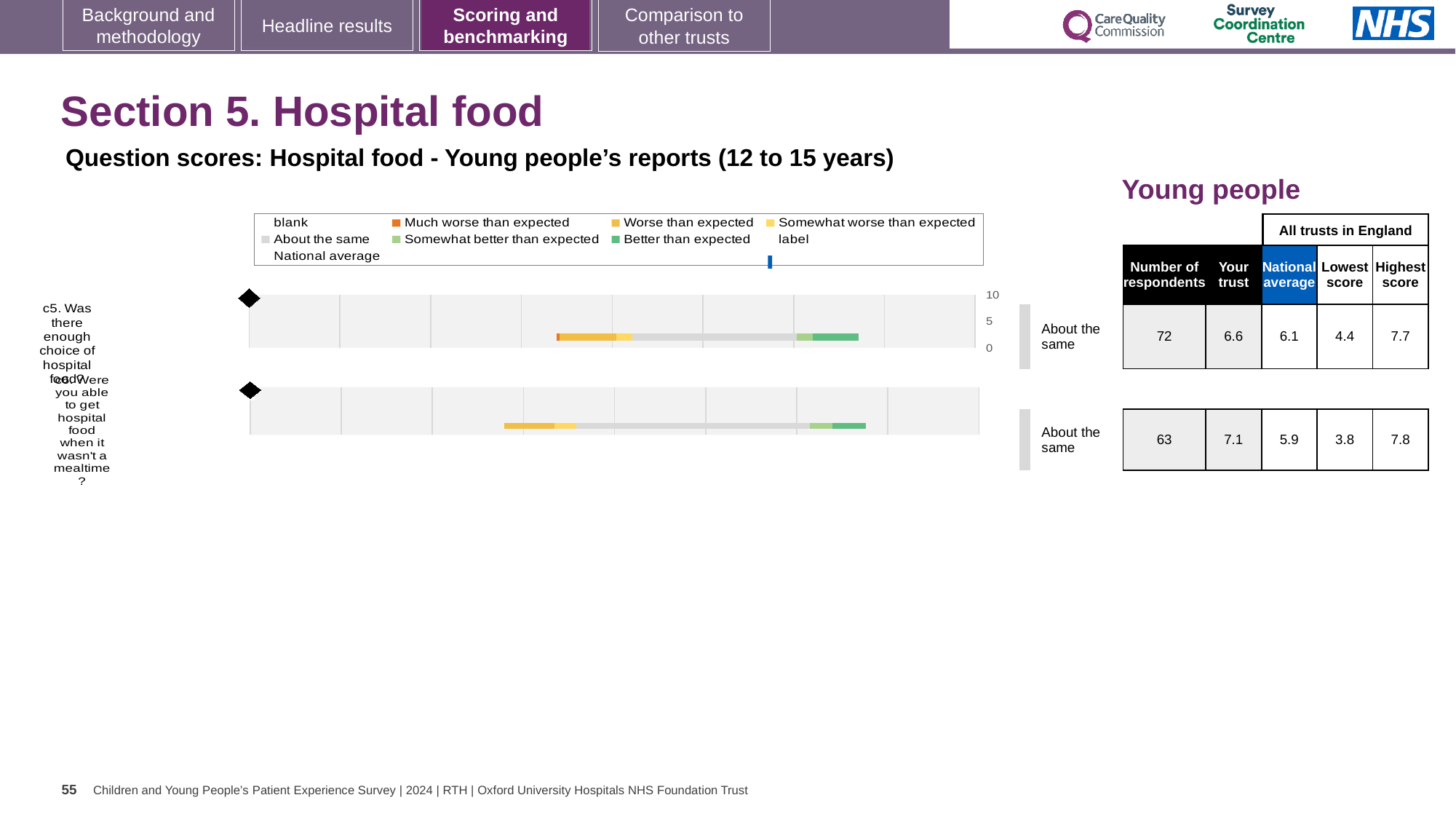
What is the lowest score across all trusts in England for question c6? 3.8 How many survey questions are plotted in the hospital food chart? 2 What benchmark category is given for question c5? About the same Which legend entry is shown in dark orange in the hospital food chart? Much worse than expected What is the 'Your trust' score for question c5 (Was there enough choice of hospital food?)? 6.6 By how much does the trust's score for c6 exceed the national average for c6? 1.2 Which question has the higher 'Your trust' score, c5 or c6? c6 How many respondents answered question c5? 72 What is the difference between the highest and lowest trust scores for question c5? 3.3 What kind of chart is used to show the question scores for hospital food? bar chart What is the national average score for question c6 (Were you able to get hospital food when it wasn't a mealtime?)? 5.9 What is the highest value shown on the chart's score axis? 10